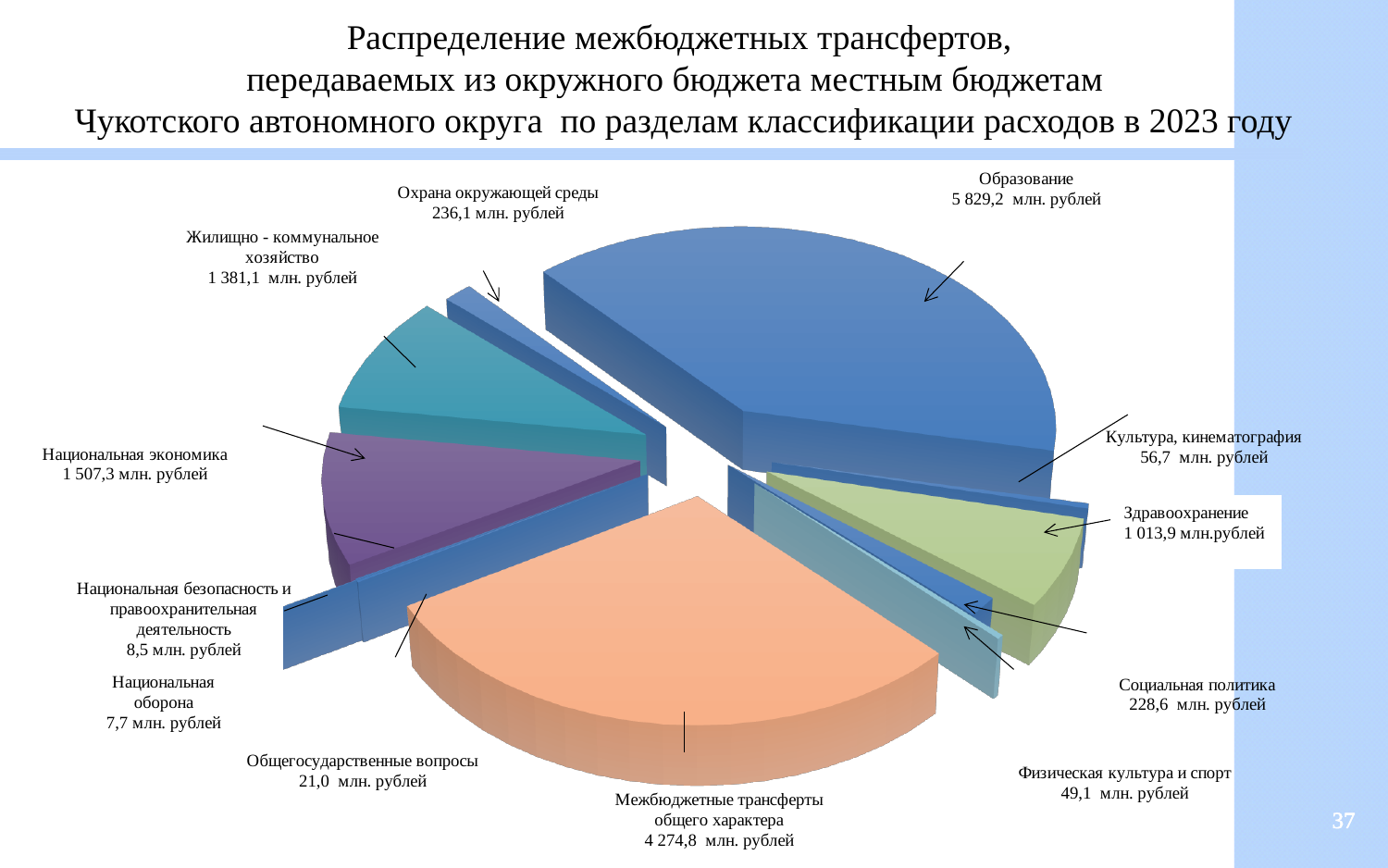
Which category has the smallest value? Национальная оборона What kind of chart is shown on the slide? pie chart What is the difference between Образование and Межбюджетные трансферты общего характера? 1 554,4 млн. рублей What is the value for Национальная оборона? 7,7 млн. рублей Which category has the largest value? Образование How many categories (sections) does the pie chart show? 12 What is the value for Межбюджетные трансферты общего характера? 4 274,8 млн. рублей Which is larger, Социальная политика or Охрана окружающей среды? Охрана окружающей среды Which year does the chart title refer to? 2023 What is the value for Здравоохранение? 1 013,9 млн.рублей What is the difference between Национальная экономика and Жилищно-коммунальное хозяйство? 126,2 млн. рублей What is the value for Образование? 5 829,2 млн. рублей